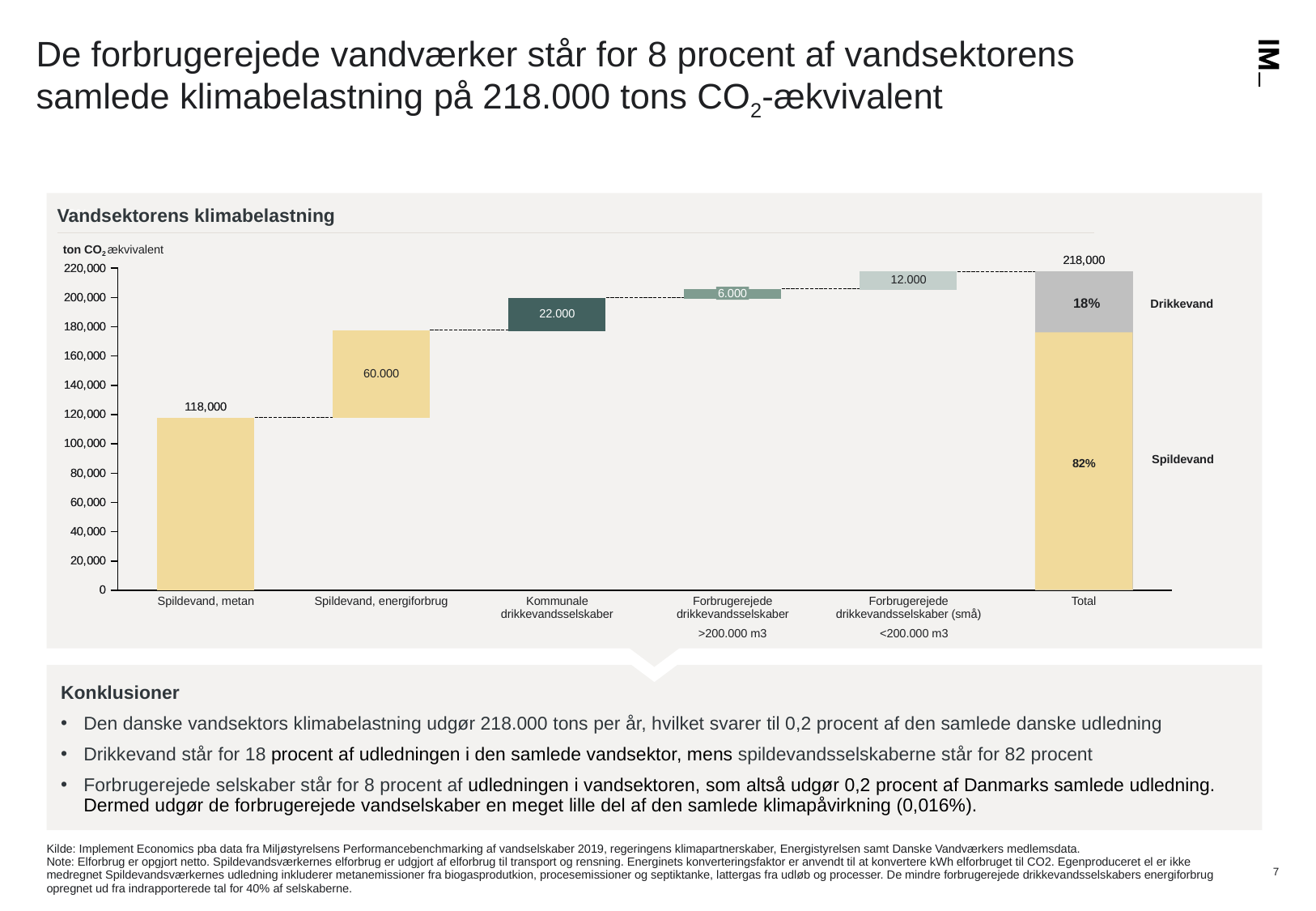
Which category, excluding Total, has the highest value? Spildevand, metan Which is larger: Kommunale drikkevandsselskaber or Forbrugerejede drikkevandsselskaber (små)? Kommunale drikkevandsselskaber What is the value for Spildevand, energiforbrug? 60.000 What is the value for Forbrugerejede drikkevandsselskaber (små) <200.000 m3? 12.000 What share of the Total bar is Drikkevand? 18% What is the value for Spildevand, metan? 118,000 What is the value for Kommunale drikkevandsselskaber? 22.000 What is the difference between Kommunale drikkevandsselskaber and Forbrugerejede drikkevandsselskaber (små)? 10.000 How many categories are shown on the x axis? 6 Which category has the lowest value? Forbrugerejede drikkevandsselskaber >200.000 m3 What is the title of the chart? Vandsektorens klimabelastning What is the value of the Total bar? 218,000